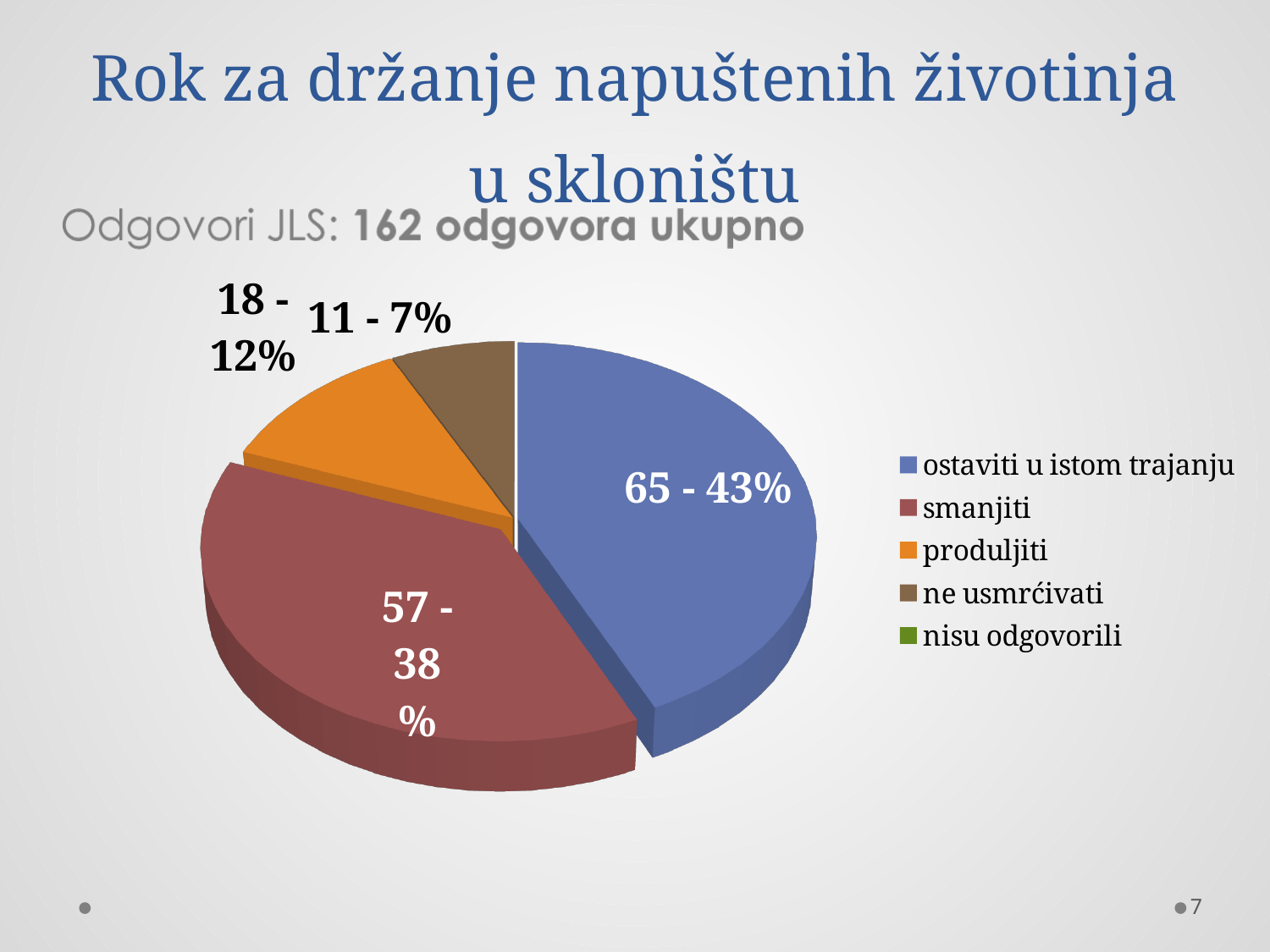
What is the count and percentage shown for 'ostaviti u istom trajanju'? 65 - 43% Which category has the largest slice of the pie? ostaviti u istom trajanju Which has more responses, 'produljiti' or 'ne usmrćivati'? produljiti What kind of chart is shown on the slide? pie chart How many entries does the legend list? 5 Which colour represents 'smanjiti' in the pie chart? red What is the count and percentage shown for 'smanjiti'? 57 - 38% What is the difference in the number of responses between 'ostaviti u istom trajanju' and 'smanjiti'? 8 How many slices are visible in the pie chart? 4 What percentage of responses is shown for 'ne usmrćivati'? 7% What percentage of responses is shown for 'produljiti'? 12% Which visible slice of the pie is the smallest? ne usmrćivati